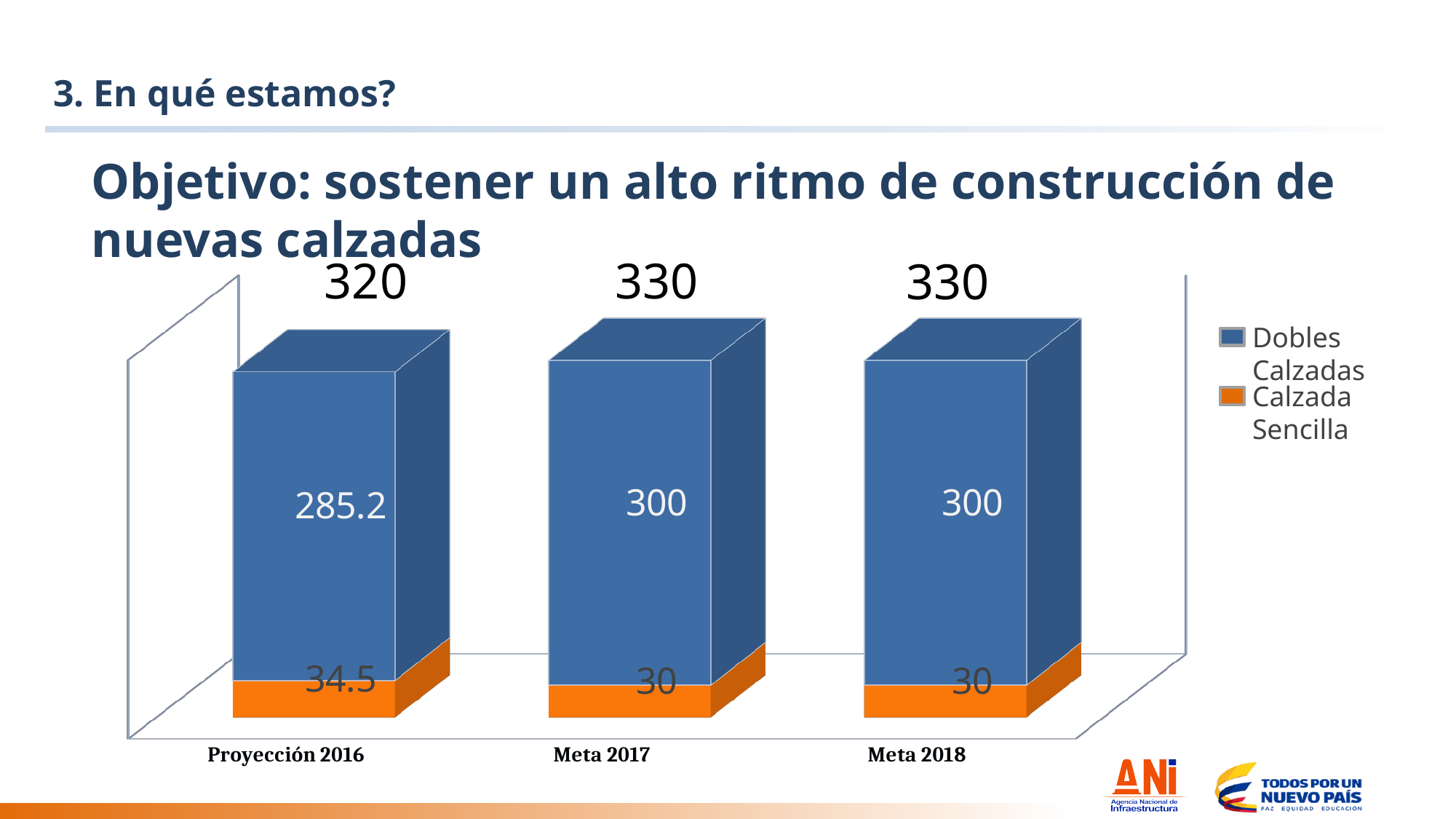
What is the value for Calzada Sencilla in Meta 2018? 30 How many series does the legend list? 2 Is the Calzada Sencilla value for Proyección 2016 larger or smaller than the Calzada Sencilla value for Meta 2017? larger Which category has the lowest value for Dobles Calzadas? Proyección 2016 What is the total of the stacked bar for Meta 2017? 330 Which category has the highest value for Calzada Sencilla? Proyección 2016 What is the value for Dobles Calzadas in Proyección 2016? 285.2 What is the value for Dobles Calzadas in Meta 2017? 300 What is the difference between the Dobles Calzadas values for Meta 2017 and Proyección 2016? 14.8 What is the total of the stacked bar for Proyección 2016? 320 How many categories are shown on the x axis? 3 What is the value for Calzada Sencilla in Proyección 2016? 34.5